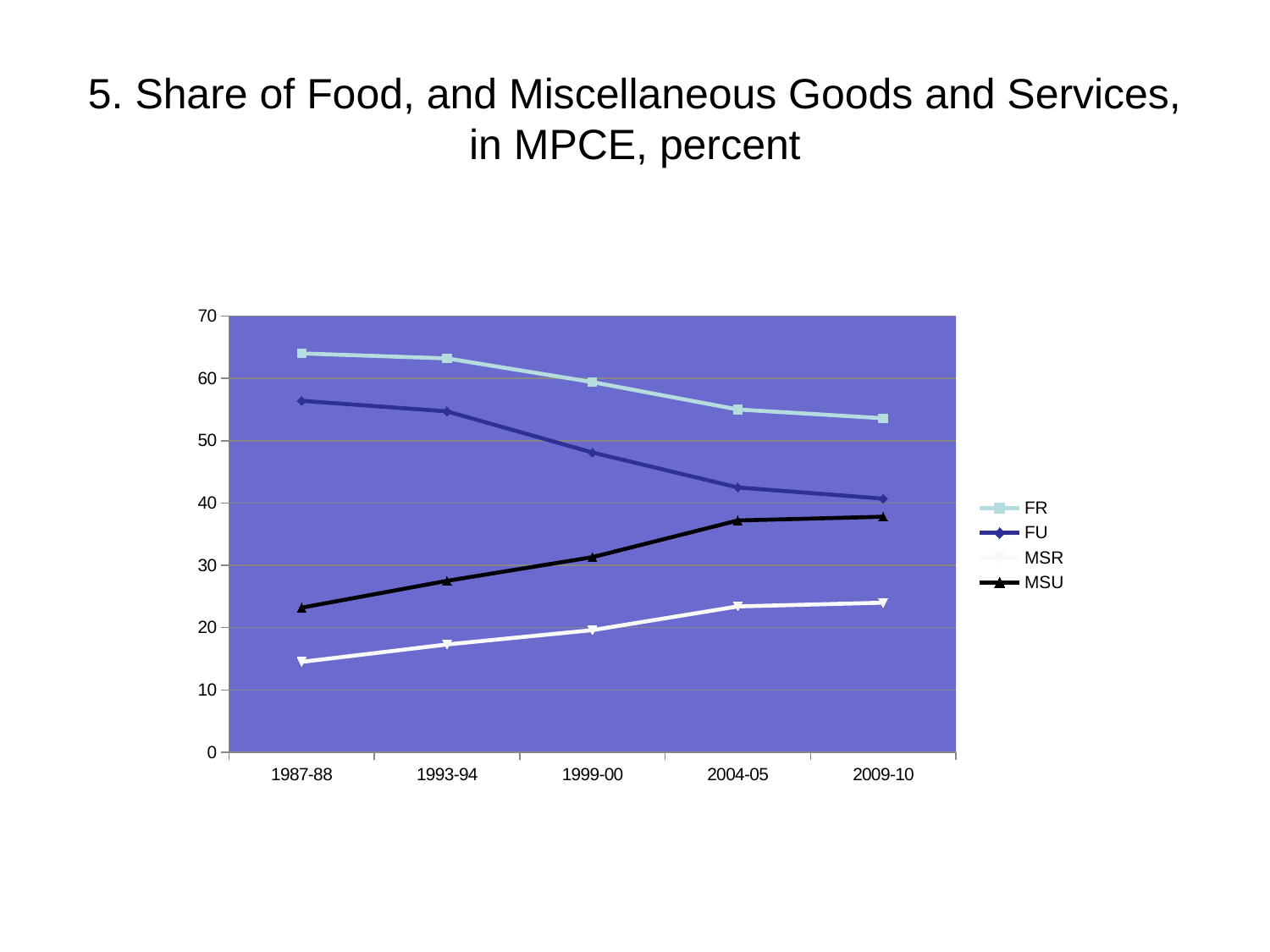
How many time periods are shown on the x axis? 5 Does the FR series rise or fall from 1987-88 to 2009-10? fall Is the value for FU in 2009-10 greater or less than 50? less Is the value for FR in 1987-88 greater or less than 60? greater Does the MSU series rise or fall from 1987-88 to 2009-10? rise In 1987-88, which is larger, MSU or MSR? MSU What kind of chart is shown on the slide? line chart Is the value for MSR in 1987-88 greater or less than 20? less How many series does the legend list? 4 Which series has the lowest value in 2009-10? MSR In 2009-10, which is larger, FR or FU? FR Which series has the highest value in 1987-88? FR